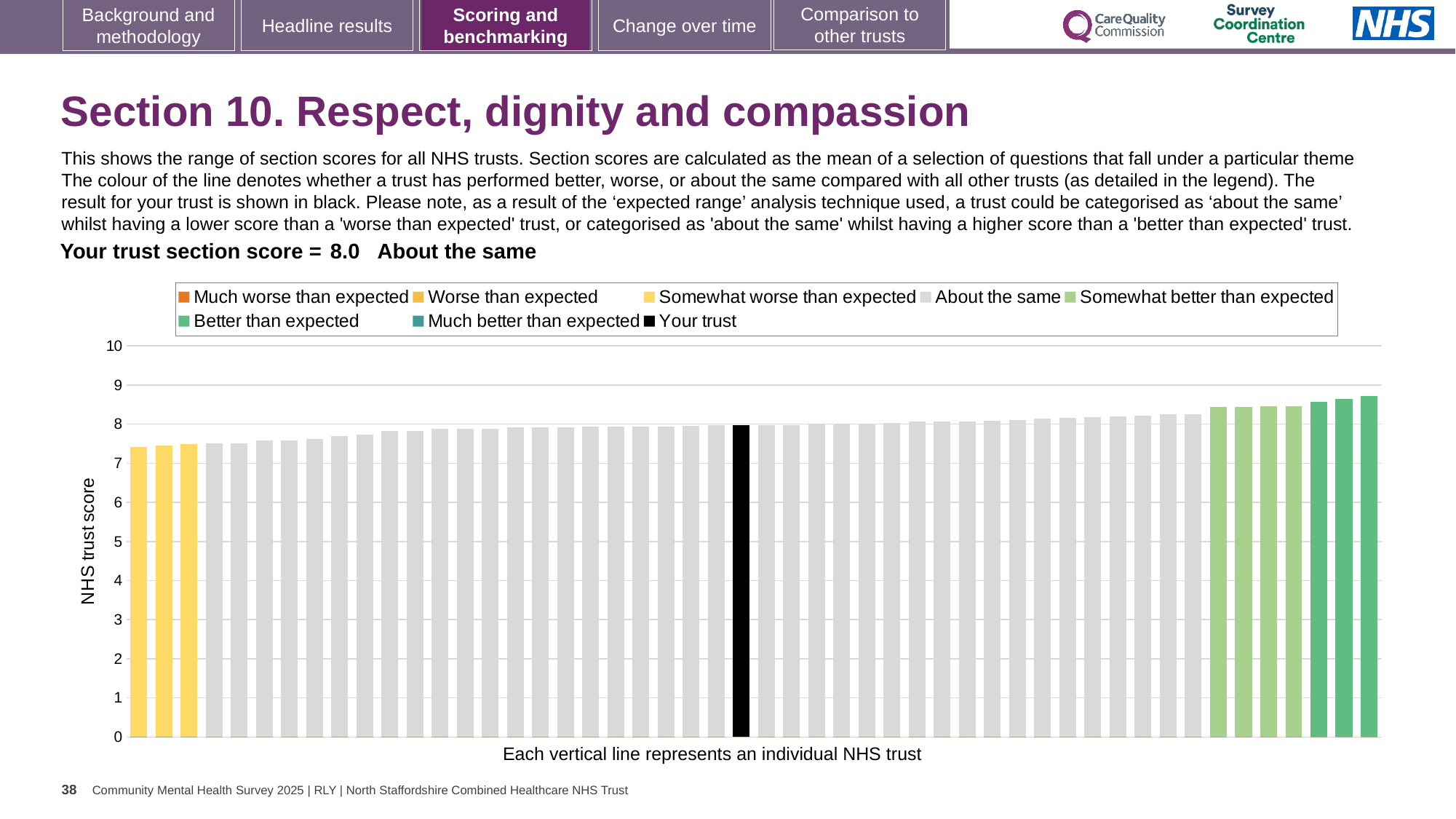
Is the highest bar on the chart greater or less than 9? less How many green bars (both shades) are shown on the chart? 7 Which category is your trust placed in for this section? About the same What kind of chart is shown on the slide? bar chart What colour is the bar representing your trust? black How many entries does the chart legend list? 8 Is the value for your trust (the black bar) greater or less than 5? greater What is the section score for your trust? 8.0 Is the lowest bar on the chart greater or less than 7? greater How many yellow bars are shown on the chart? 3 What is the title of the vertical axis? NHS trust score Do the bar values rise or fall from left to right along the x axis? rise